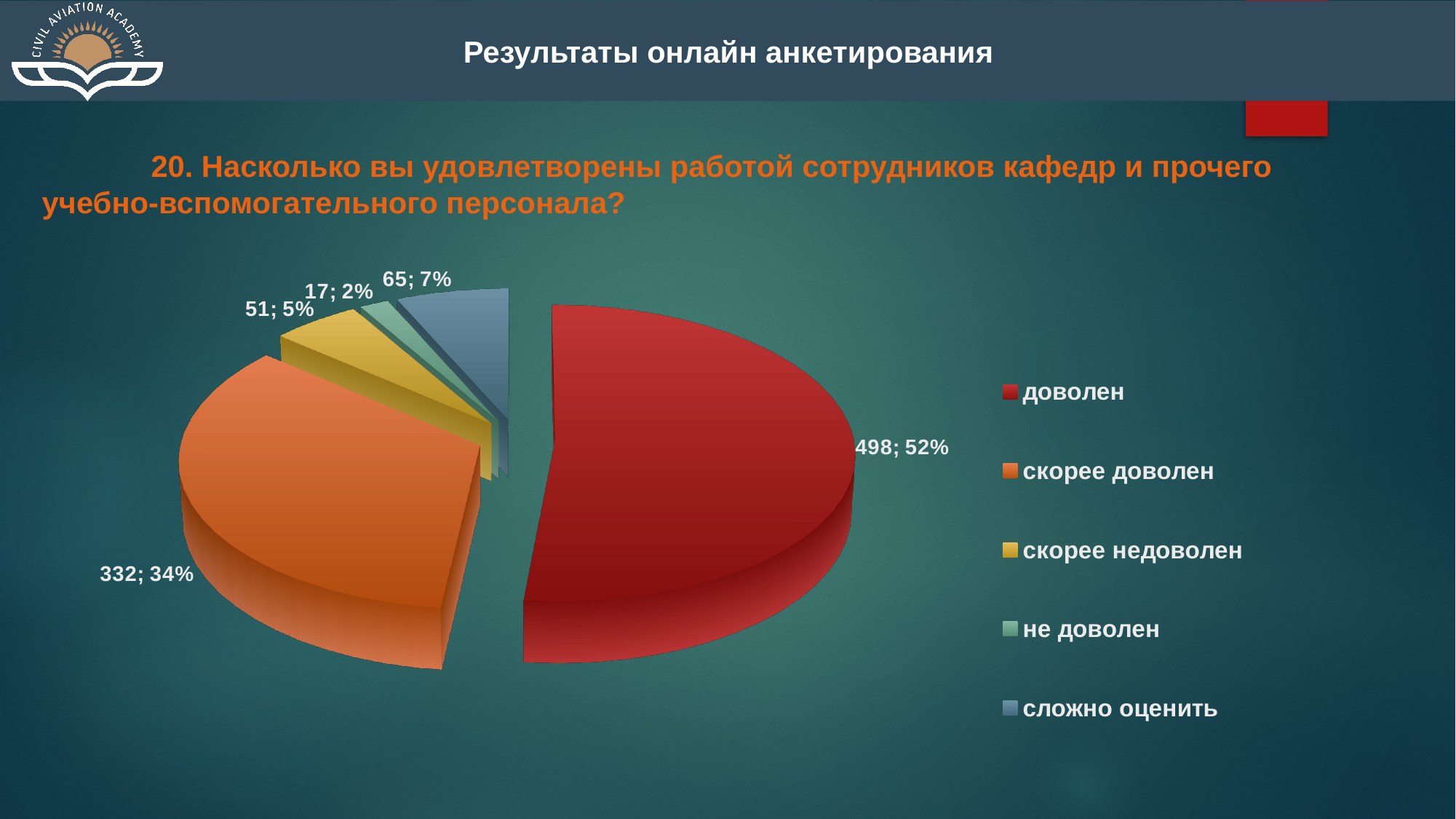
Which has more respondents, "сложно оценить" or "скорее недоволен"? сложно оценить What percentage of respondents answered "не доволен"? 2% How many respondents answered "доволен"? 498 Which category has the largest slice of the pie? доволен How many respondents answered "скорее недоволен"? 51 What share of the pie does "скорее доволен" represent? 34% What is the difference in respondents between "доволен" and "скорее доволен"? 166 What type of chart is shown on the slide? pie chart How many respondents answered "сложно оценить"? 65 What colour is the slice for "скорее недоволен"? yellow Which category has the smallest slice of the pie? не доволен How many categories does the pie chart have? 5